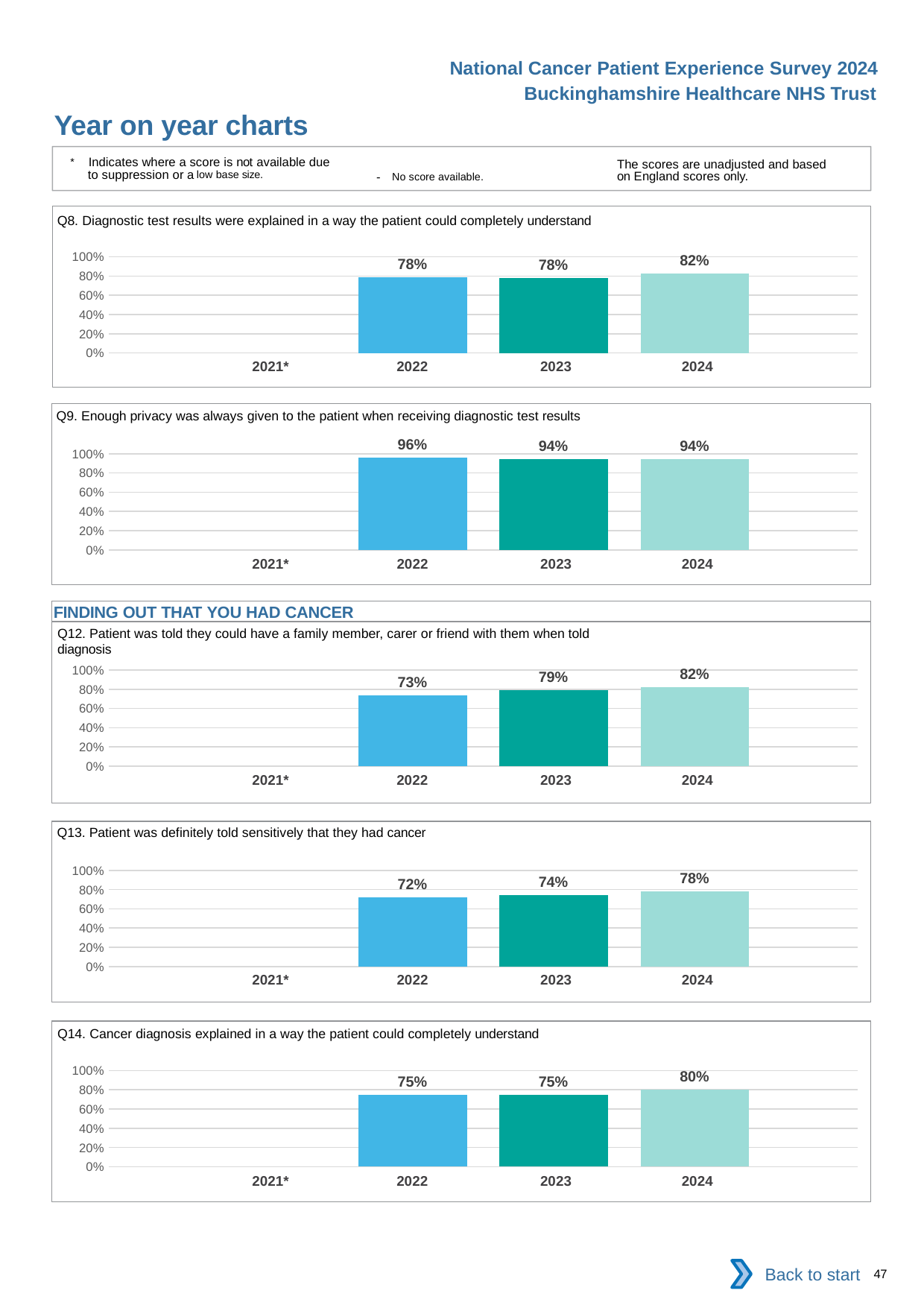
In the Q13 chart, is the value for 2023 larger or smaller than the value for 2024? smaller In the Q8 chart, which year has no bar plotted? 2021* In the Q14 chart, what is the value for 2023? 75% In the Q8 chart, what is the value for 2024? 82% In the Q9 chart, what is the value for 2022? 96% What kind of chart is the Q13 chart? bar chart How many years are shown on the x axis of the Q8 chart? 4 In the Q12 chart, what is the difference between the 2024 and 2022 values? 9 percentage points In the Q12 chart, which year has the lowest value? 2022 In the Q13 chart, do the values rise or fall from 2022 to 2024? rise In the Q9 chart, which year has the highest value? 2022 In the Q14 chart, is the value for 2024 greater or less than 60%? greater